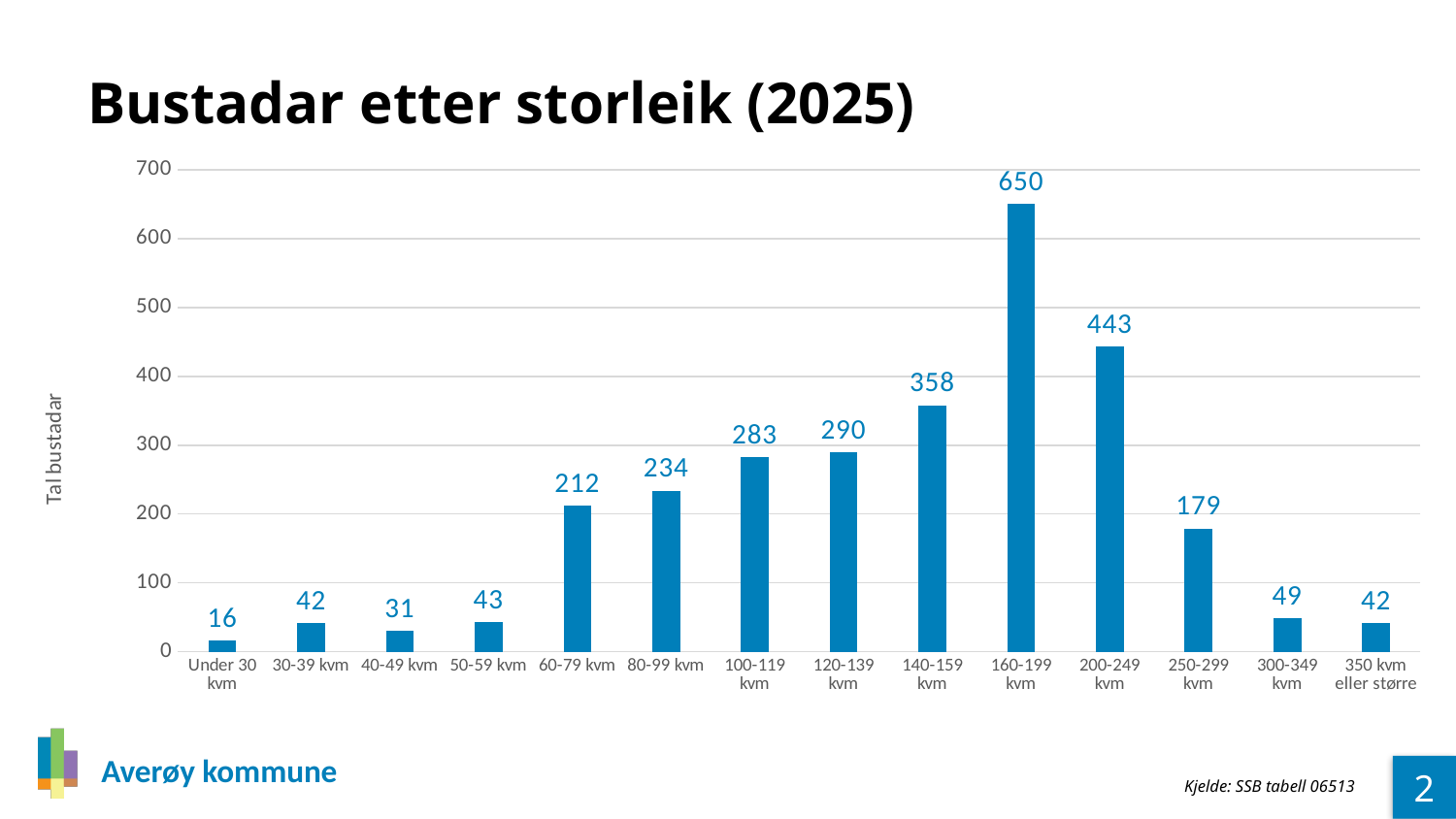
What is the label on the y axis? Tal bustadar Is the value for 140-159 kvm greater or less than 300? greater What is the title of the chart? Bustadar etter storleik (2025) What is the difference between the values for 160-199 kvm and 200-249 kvm? 207 What kind of chart is this? Bar chart Which is larger, the value for 60-79 kvm or the value for 80-99 kvm? 80-99 kvm Which category has the lowest value? Under 30 kvm What is the value for 160-199 kvm? 650 What is the value for Under 30 kvm? 16 What is the value for 250-299 kvm? 179 Which category has the highest value? 160-199 kvm How many categories are shown on the x axis? 14